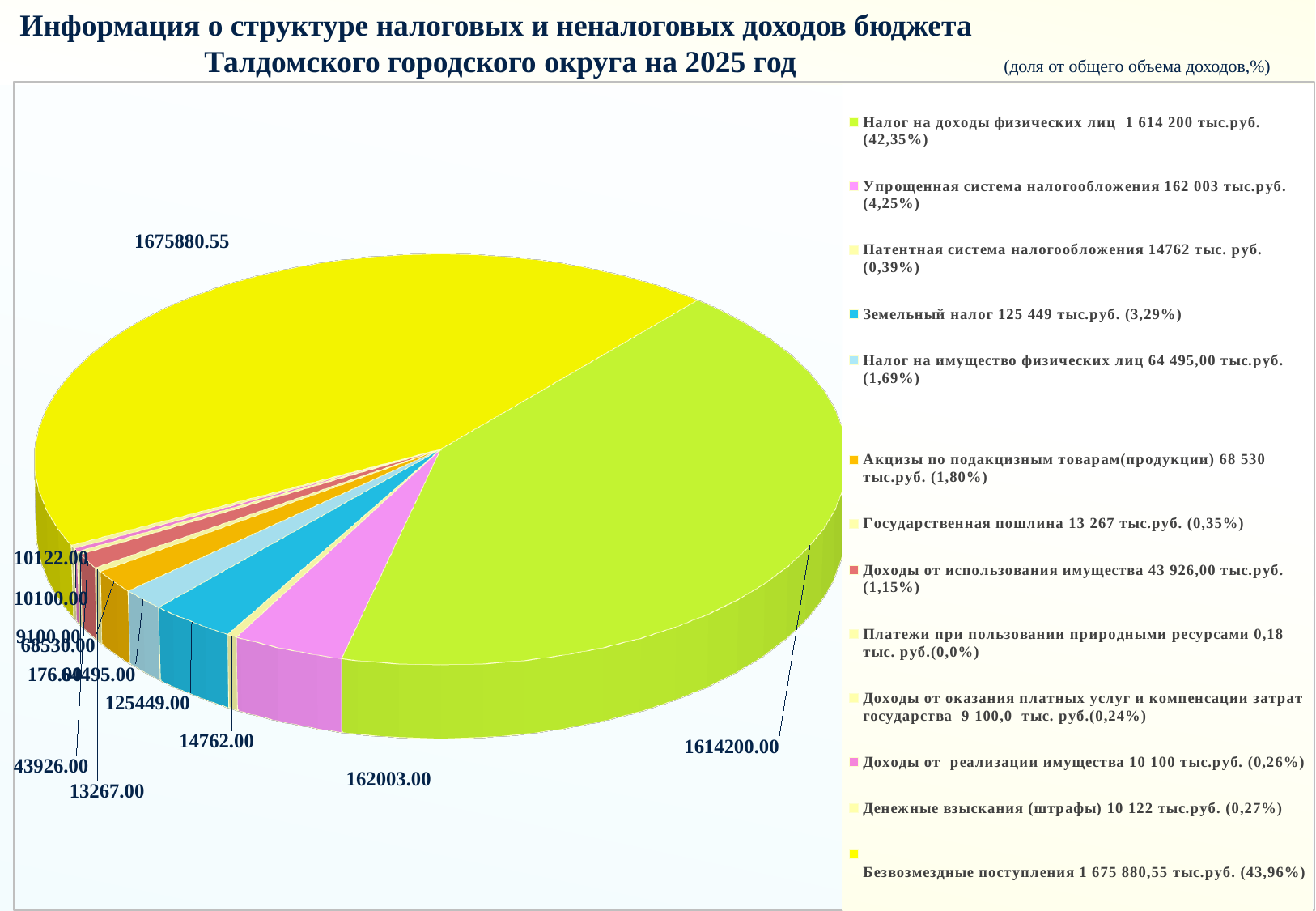
What is the difference between the data labels for Безвозмездные поступления (1675880.55) and Налог на доходы физических лиц (1614200.00)? 61680.55 What share of total revenue does Налог на доходы физических лиц represent according to the legend? 42,35% Which is larger: Акцизы по подакцизным товарам or Налог на имущество физических лиц? Акцизы по подакцизным товарам What kind of chart is shown on the slide? Pie chart Which category has the smallest value according to the legend? Платежи при пользовании природными ресурсами What share of total revenue does Безвозмездные поступления represent according to the legend? 43,96% Which category has the largest slice of the pie? Безвозмездные поступления What is the difference between the data labels for Упрощенная система налогообложения (162003.00) and Земельный налог (125449.00)? 36554.00 What is the data label value for Государственная пошлина? 13267.00 What is the data label value for Земельный налог? 125449.00 How many categories does the legend of the pie chart list? 13 What year does the chart title say the budget revenue structure refers to? 2025